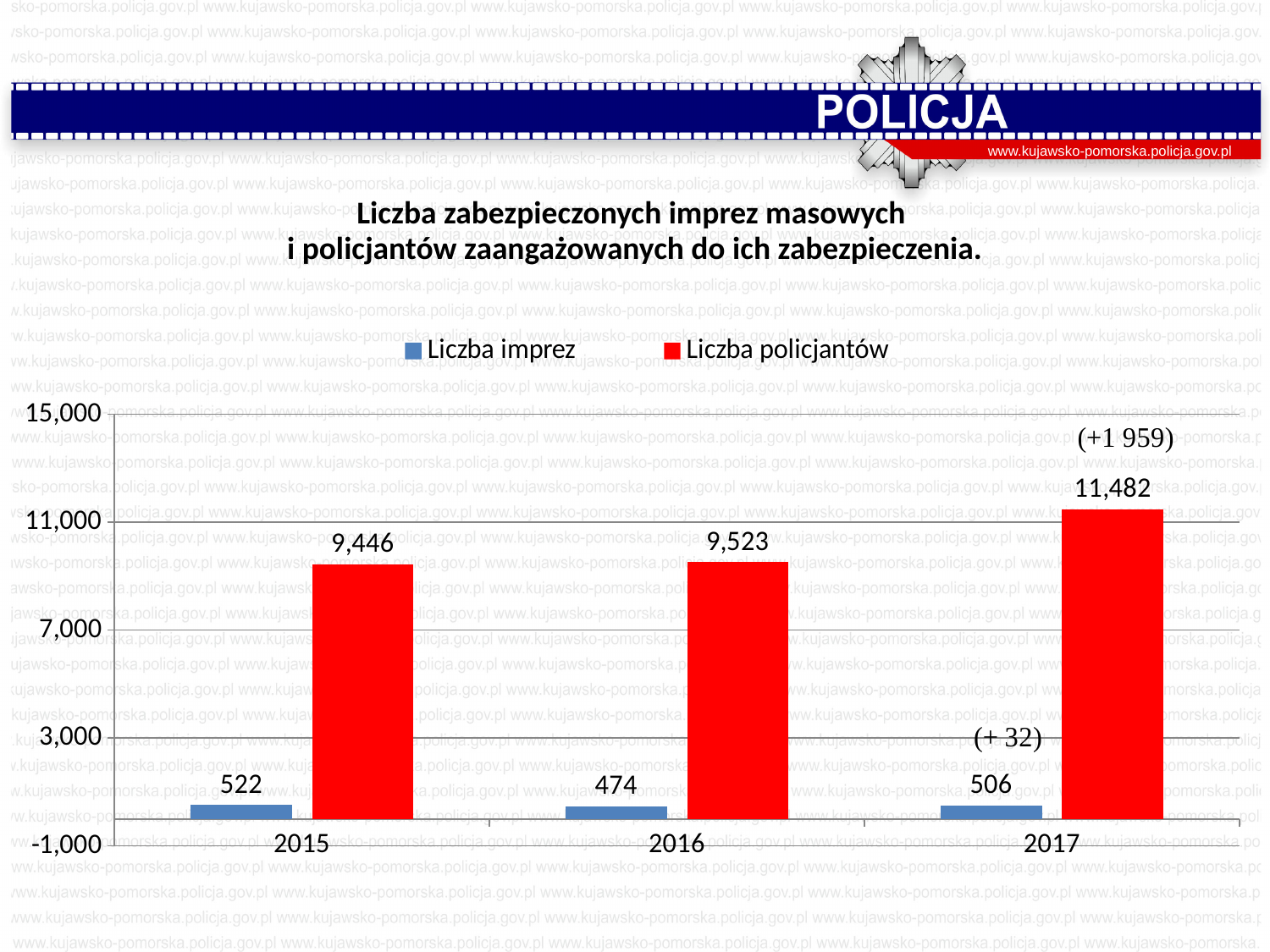
What is the difference between Liczba imprez in 2015 and in 2016? 48 What kind of chart is shown on the slide? bar chart What is the difference between Liczba policjantów in 2017 and in 2016? 1,959 How many series does the legend list? 2 What is the value of Liczba policjantów for 2017? 11,482 How many years are shown on the x axis? 3 Which year has the highest value for Liczba policjantów? 2017 What is the value of Liczba policjantów for 2015? 9,446 What is the value of Liczba imprez for 2016? 474 Is the value of Liczba policjantów for 2016 greater or less than 11,000? less Which year has the lowest value for Liczba imprez? 2016 Which is larger: Liczba imprez in 2015 or Liczba imprez in 2017? 2015